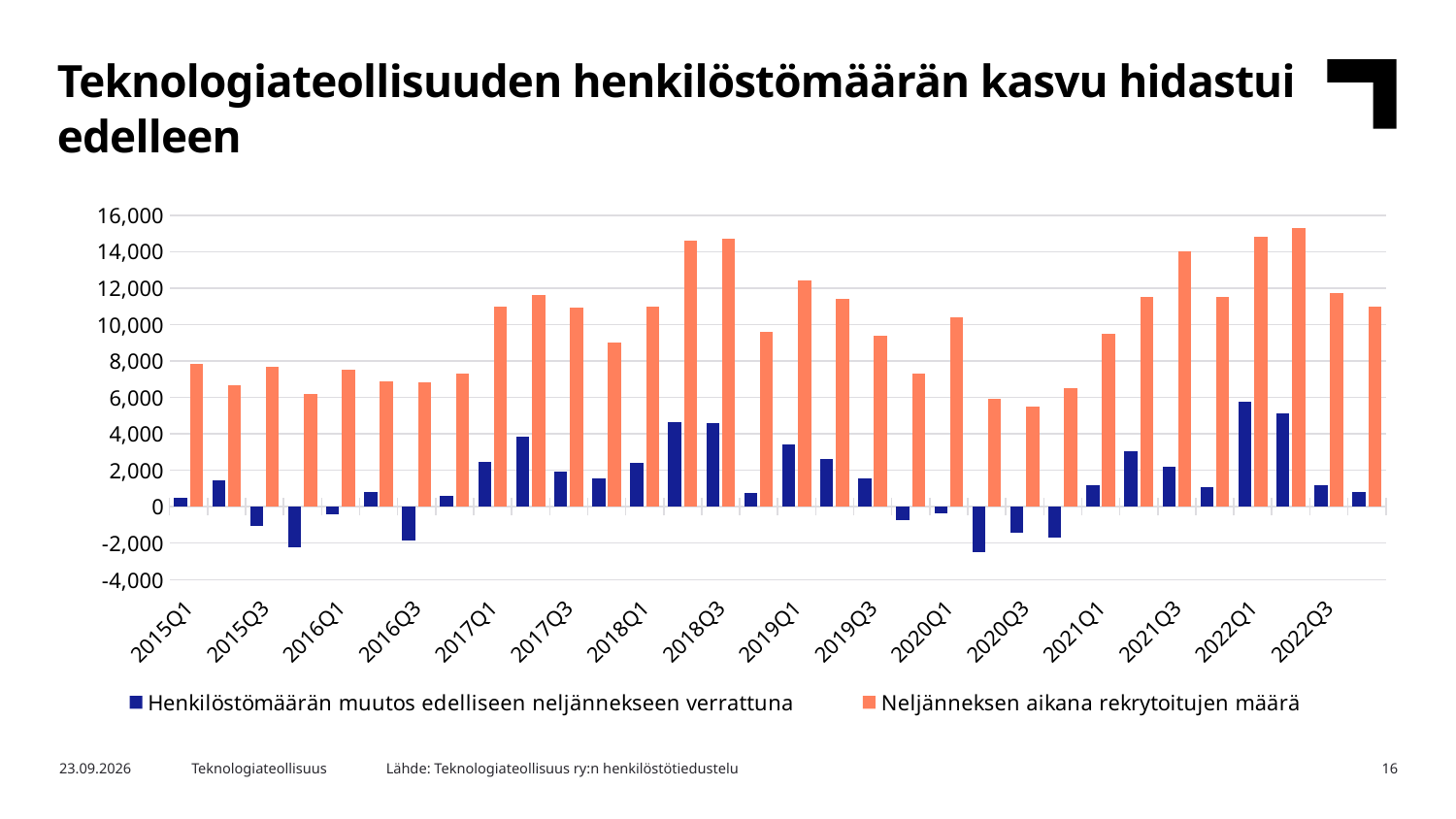
What is the title of the slide? Teknologiateollisuuden henkilöstömäärän kasvu hidastui edelleen How many series does the legend list? 2 Which is larger for Neljänneksen aikana rekrytoitujen määrä: 2018Q3 or 2020Q3? 2018Q3 Which series is shown in orange according to the legend? Neljänneksen aikana rekrytoitujen määrä Is the value of Neljänneksen aikana rekrytoitujen määrä for 2018Q3 greater or less than 14,000? greater Is the value of Henkilöstömäärän muutos edelliseen neljännekseen verrattuna for 2018Q3 greater or less than 4,000? greater Is the value of Henkilöstömäärän muutos edelliseen neljännekseen verrattuna for 2016Q3 greater or less than 0? less How many quarter labels are printed on the x axis? 16 Which quarter has the highest value of Henkilöstömäärän muutos edelliseen neljännekseen verrattuna? 2022Q1 Does the value of Neljänneksen aikana rekrytoitujen määrä rise or fall from 2020Q3 to 2022Q1? rise What kind of chart is shown on the slide? bar chart